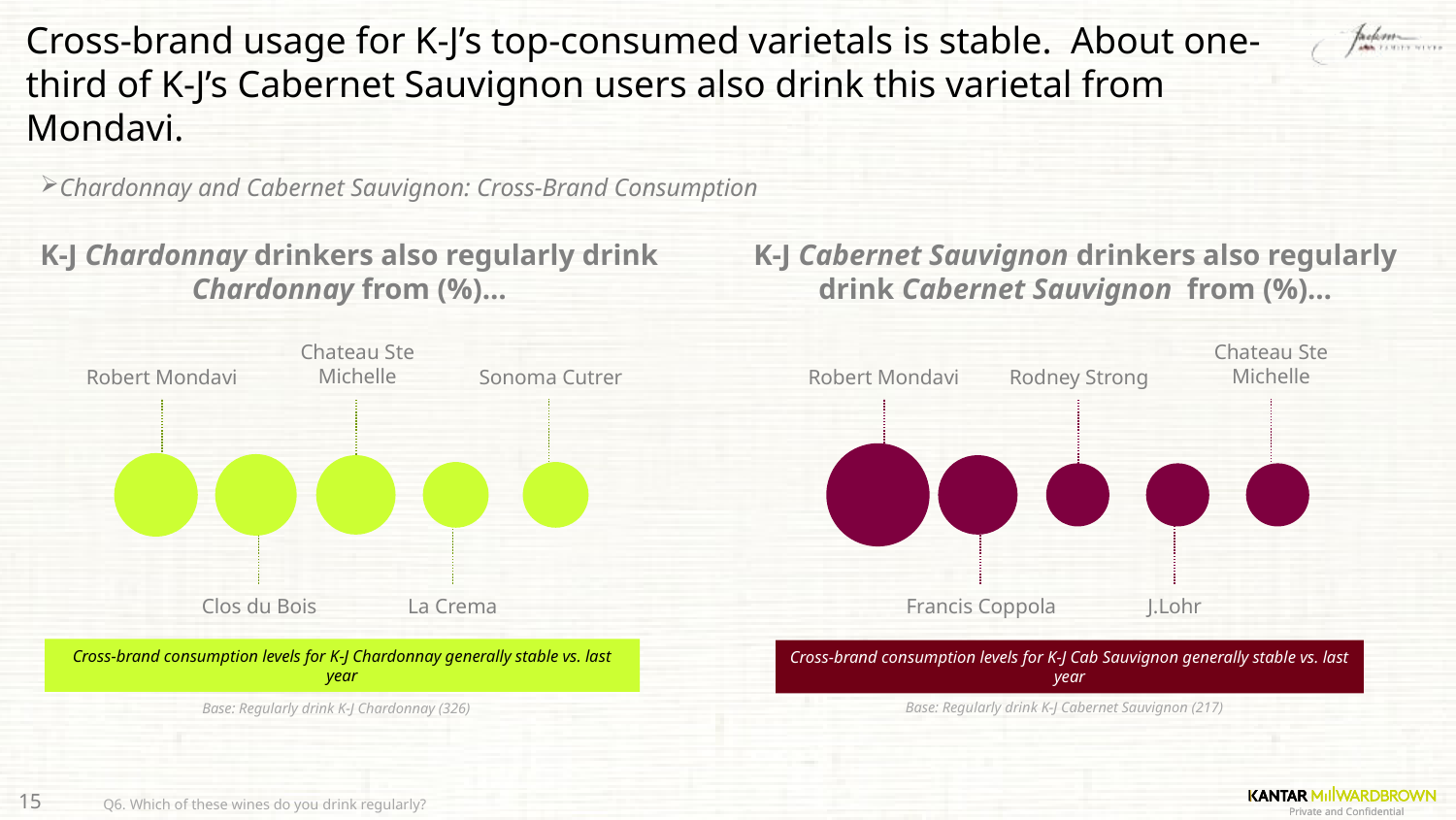
What colour are the bubbles in the right chart (Cabernet Sauvignon)? Maroon In the right chart (Cabernet Sauvignon), which brand has the largest bubble? Robert Mondavi In the left chart (Chardonnay), which brand is listed between Robert Mondavi and Chateau Ste Michelle along the bottom row of labels? Clos du Bois How many brands are shown in the left chart, 'K-J Chardonnay drinkers also regularly drink Chardonnay from (%)...'? 5 In the right chart (Cabernet Sauvignon), which is larger: the bubble for Francis Coppola or the bubble for Rodney Strong? Francis Coppola In the right chart (Cabernet Sauvignon), which is larger: the bubble for Robert Mondavi or the bubble for J.Lohr? Robert Mondavi How many brands are shown in the right chart, 'K-J Cabernet Sauvignon drinkers also regularly drink Cabernet Sauvignon from (%)...'? 5 In the left chart (Chardonnay), which is larger: the bubble for Robert Mondavi or the bubble for Sonoma Cutrer? Robert Mondavi What kind of chart is used on the left side of the slide for Chardonnay cross-brand consumption? Bubble chart Which brand appears in both the Chardonnay chart and the Cabernet Sauvignon chart besides Robert Mondavi? Chateau Ste Michelle